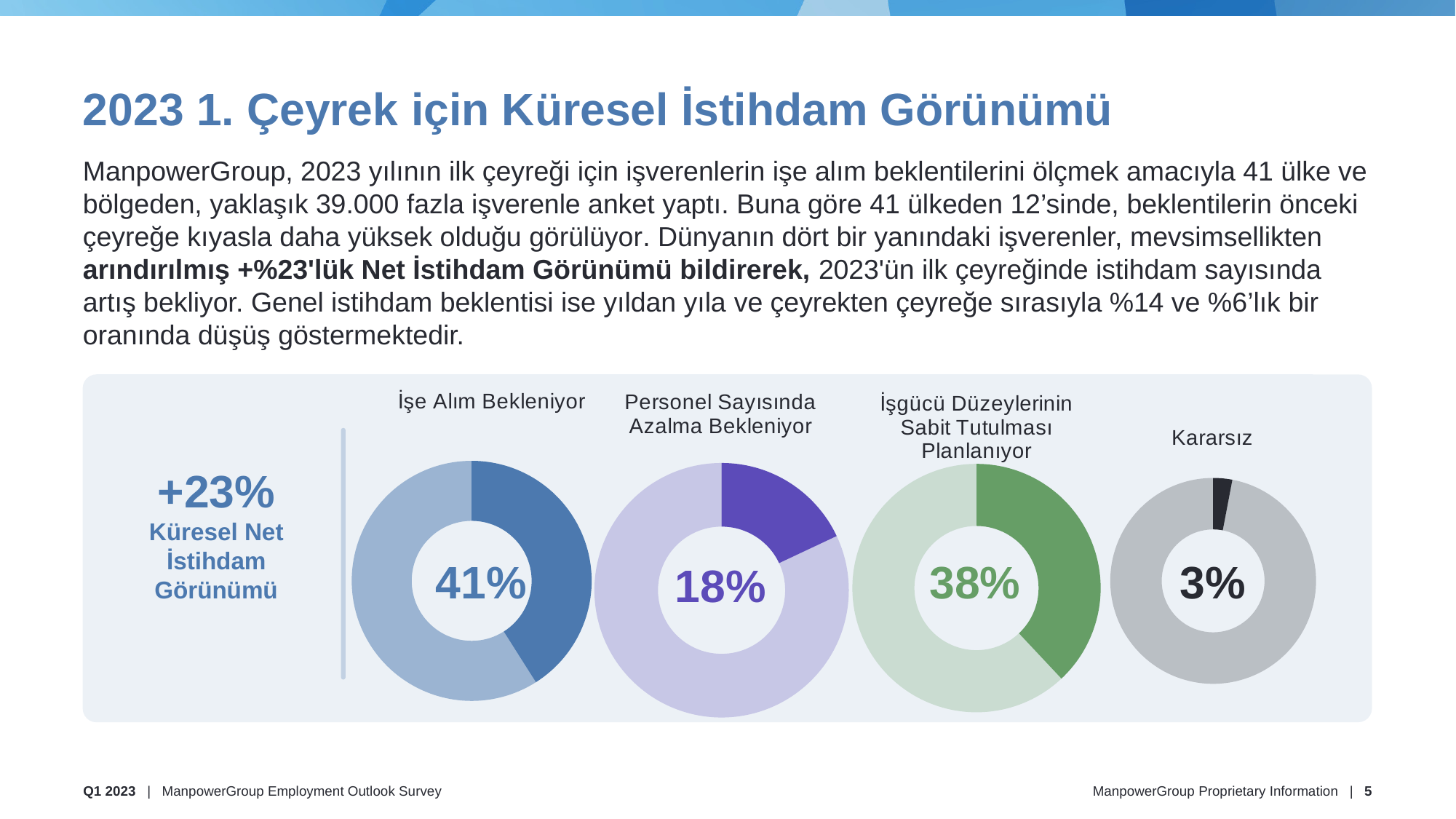
How many donut charts are shown on the slide? 4 What value is shown in the centre of the "İşgücü Düzeylerinin Sabit Tutulması Planlanıyor" donut chart? 38% What Küresel Net İstihdam Görünümü value is shown to the left of the donut charts? +23% Which is larger: the "Personel Sayısında Azalma Bekleniyor" value or the "İşgücü Düzeylerinin Sabit Tutulması Planlanıyor" value? İşgücü Düzeylerinin Sabit Tutulması Planlanıyor What is the difference between the "Personel Sayısında Azalma Bekleniyor" value and the "Kararsız" value? 15% What value is shown in the centre of the "Personel Sayısında Azalma Bekleniyor" donut chart? 18% What is the difference between the "İşe Alım Bekleniyor" value and the "İşgücü Düzeylerinin Sabit Tutulması Planlanıyor" value? 3% What value is shown in the centre of the "İşe Alım Bekleniyor" donut chart? 41% Which of the four donut charts shows the highest percentage? İşe Alım Bekleniyor What kind of chart is used to show the "Kararsız" value? Donut chart Which of the four donut charts shows the lowest percentage? Kararsız What value is shown in the centre of the "Kararsız" donut chart? 3%